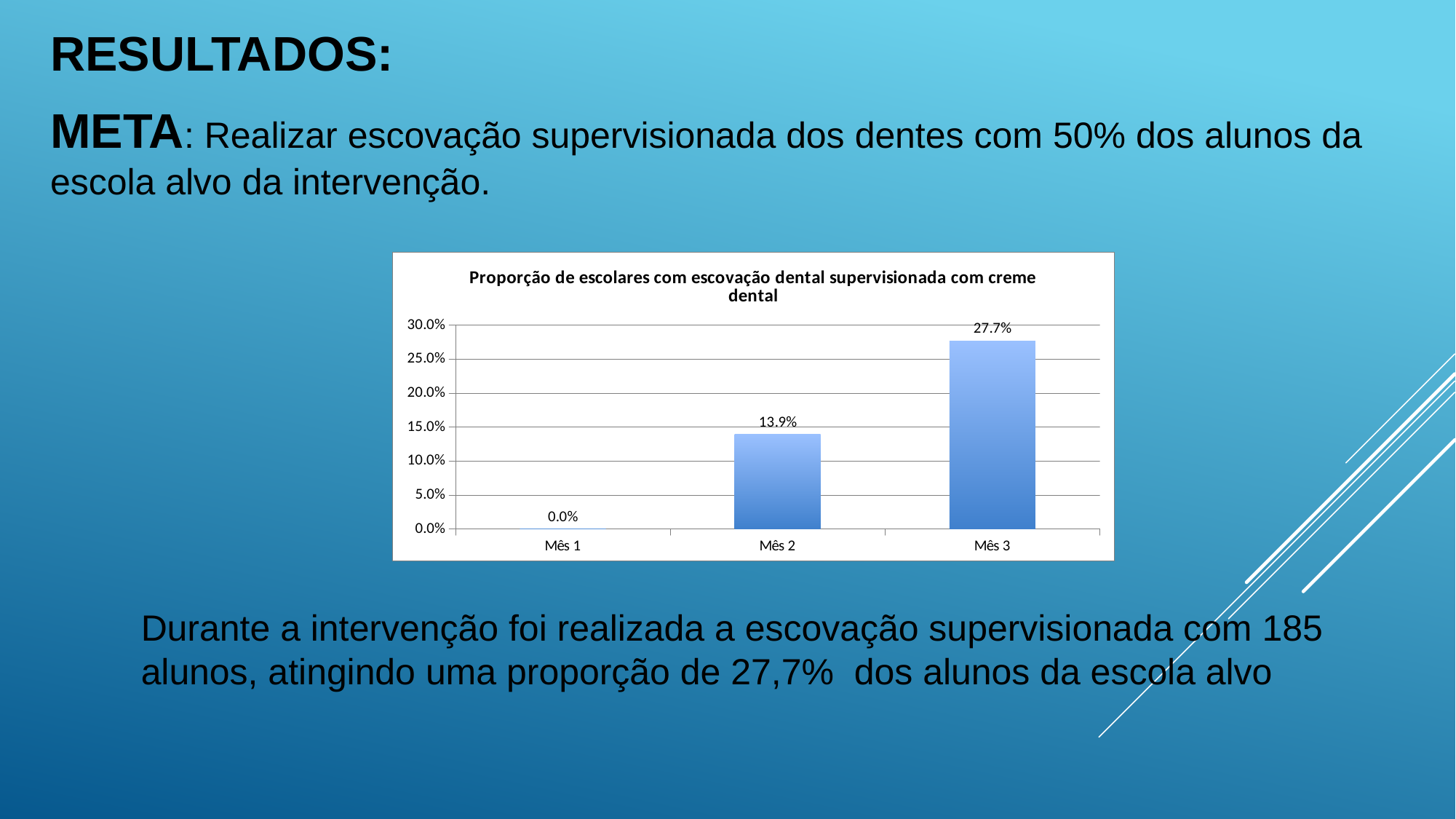
What is the value for Mês 3? 27.7% Do the values rise or fall from Mês 1 to Mês 3? rise Which month has the lowest value? Mês 1 What is the value for Mês 2? 13.9% Is the value for Mês 2 greater or less than 10.0%? greater What kind of chart is shown on the slide? bar chart What is the title of the chart? Proporção de escolares com escovação dental supervisionada com creme dental Which month has the highest value? Mês 3 What is the difference between the values for Mês 3 and Mês 2? 13.8% What is the value for Mês 1? 0.0% How many months are shown on the x axis? 3 Which is larger, the value for Mês 2 or the value for Mês 3? Mês 3